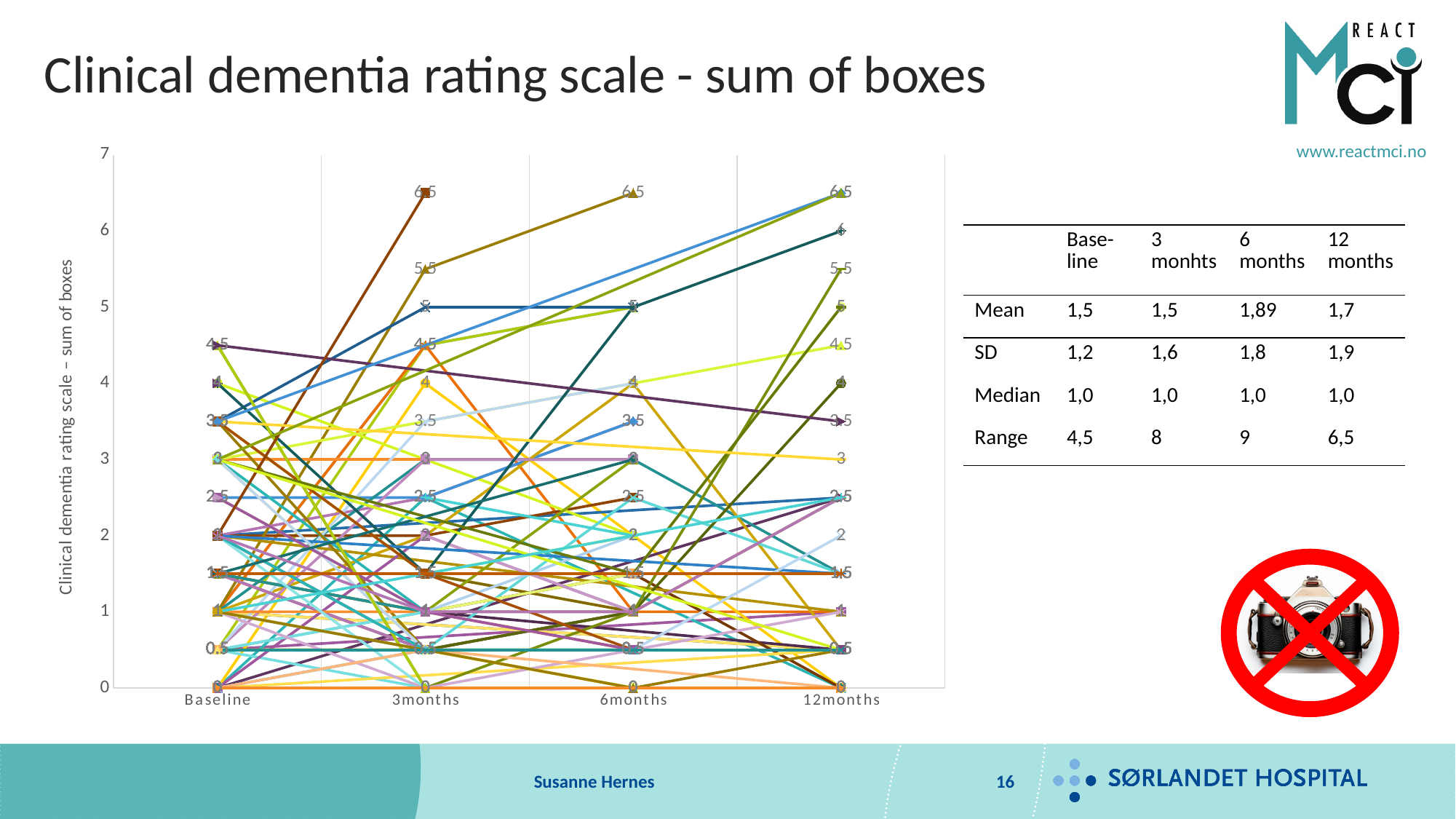
Which is larger: the highest value at Baseline or the highest value at 3months? 3months What is the lowest value plotted at Baseline in the chart? 0 What is the highest value plotted at 6months in the chart? 6.5 What is the label of the y axis of the chart? Clinical dementia rating scale – sum of boxes What is the maximum tick value shown on the y axis of the chart? 7 What kind of chart is shown on the slide? line chart How many time points are shown on the x axis of the chart? 4 What is the highest value plotted at 12months in the chart? 6.5 What is the highest value plotted at 3months in the chart? 6.5 Is the highest value plotted at Baseline greater or less than 5? less What is the difference between the highest value at 3months and the highest value at Baseline? 2